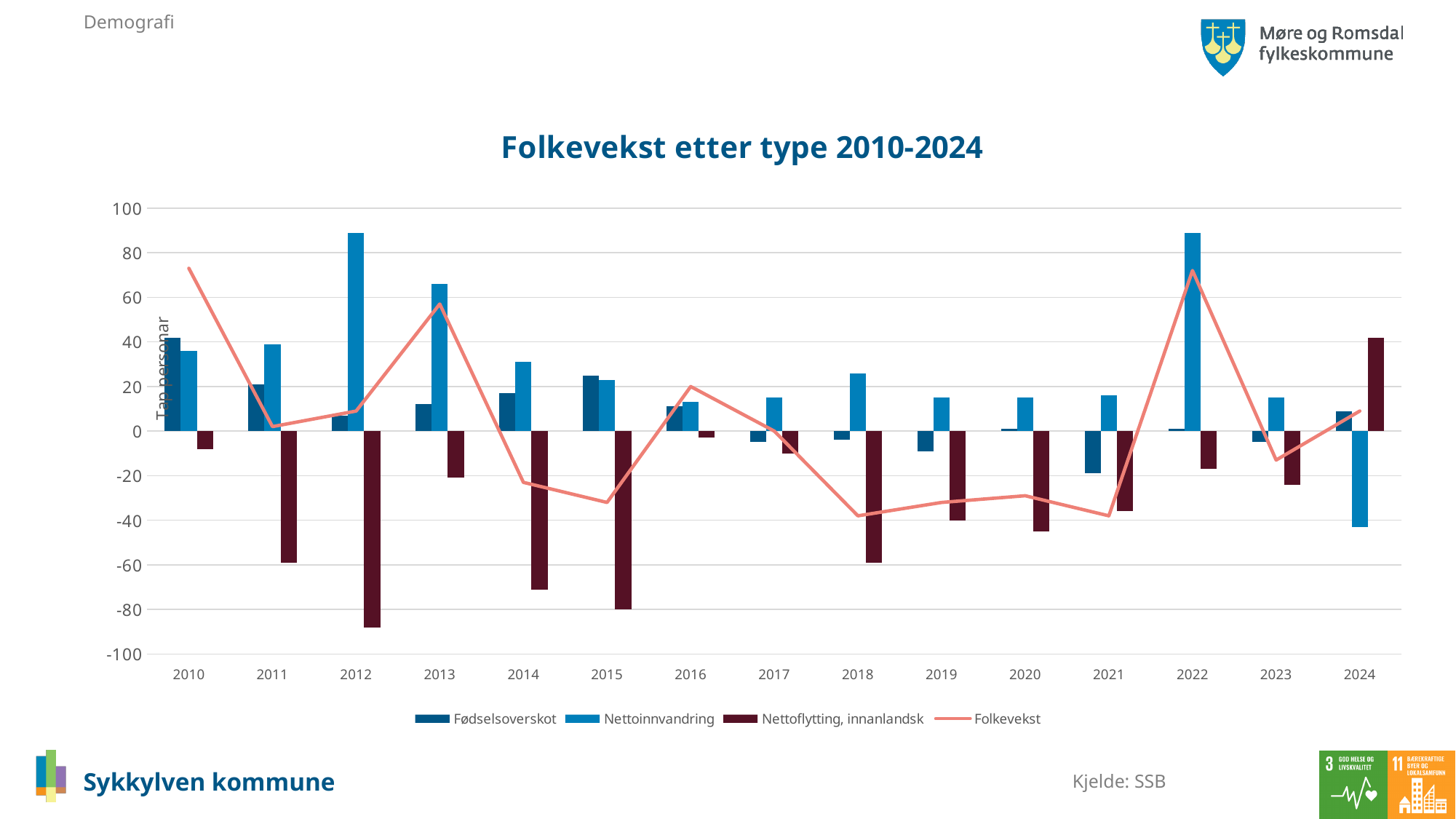
Which year has the larger Nettoinnvandring value, 2013 or 2014? 2013 What is the title of the chart? Folkevekst etter type 2010-2024 Which series is drawn as a line rather than bars? Folkevekst How many series does the legend list? 4 In which year is Nettoinnvandring lowest? 2024 How many years are shown on the x axis? 15 In which year is Nettoflytting, innanlandsk highest? 2024 What kind of chart is this? Bar chart with a line series Is the value for Nettoinnvandring in 2012 greater or less than 80? greater In which year is Fødselsoverskot highest? 2010 In which year is Nettoflytting, innanlandsk lowest? 2012 Is the value for Nettoflytting, innanlandsk in 2015 greater or less than -60? less